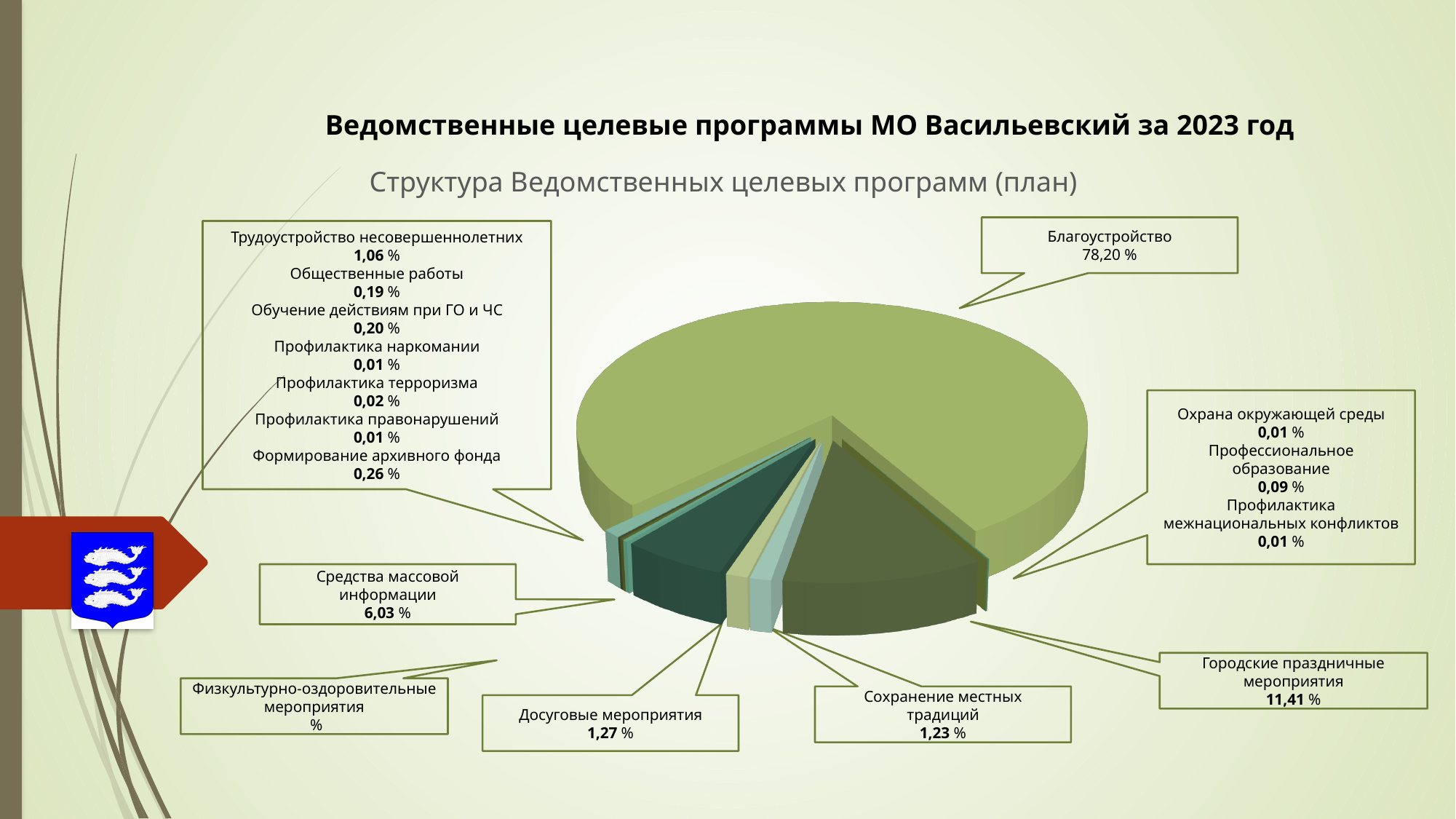
What is the value for Средства массовой информации? 6,03 % Which category has the largest share of the pie? Благоустройство What kind of chart is shown on the slide? Pie chart What is the value for Сохранение местных традиций? 1,23 % What is the value for Трудоустройство несовершеннолетних? 1,06 % Which is larger, the value for Досуговые мероприятия or the value for Сохранение местных традиций? Досуговые мероприятия What is the value for Благоустройство? 78,20 % What is the value for Формирование архивного фонда? 0,26 % What is the value for Городские праздничные мероприятия? 11,41 % What is the difference between the values for Благоустройство and Городские праздничные мероприятия? 66,79 % What is the title of the chart? Структура Ведомственных целевых программ (план) What is the value for Досуговые мероприятия? 1,27 %